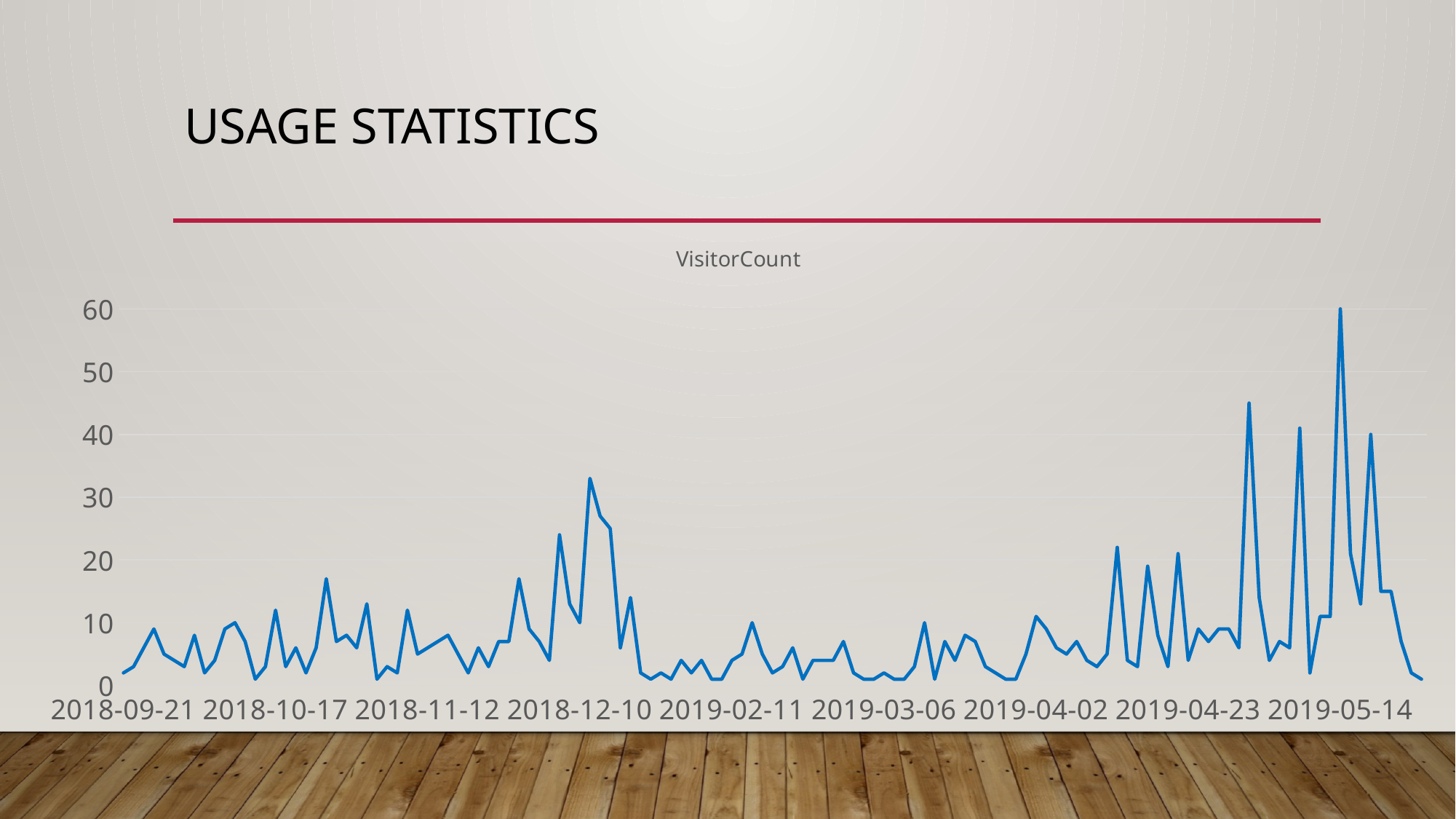
What kind of chart is shown on the slide? line chart Which is larger: the peak near 2019-05-14 or the peak near 2018-12-10? the peak near 2019-05-14 Which labelled date on the x axis has the highest visitor count? 2019-05-14 What is the title of the chart? VisitorCount Is the value for 2018-11-12 greater or less than 20? less Is the highest value on the chart greater or less than 50? greater Is the value for 2019-02-11 greater or less than 10? less What is the title of the slide? Usage Statistics What is the highest value shown on the y axis? 60